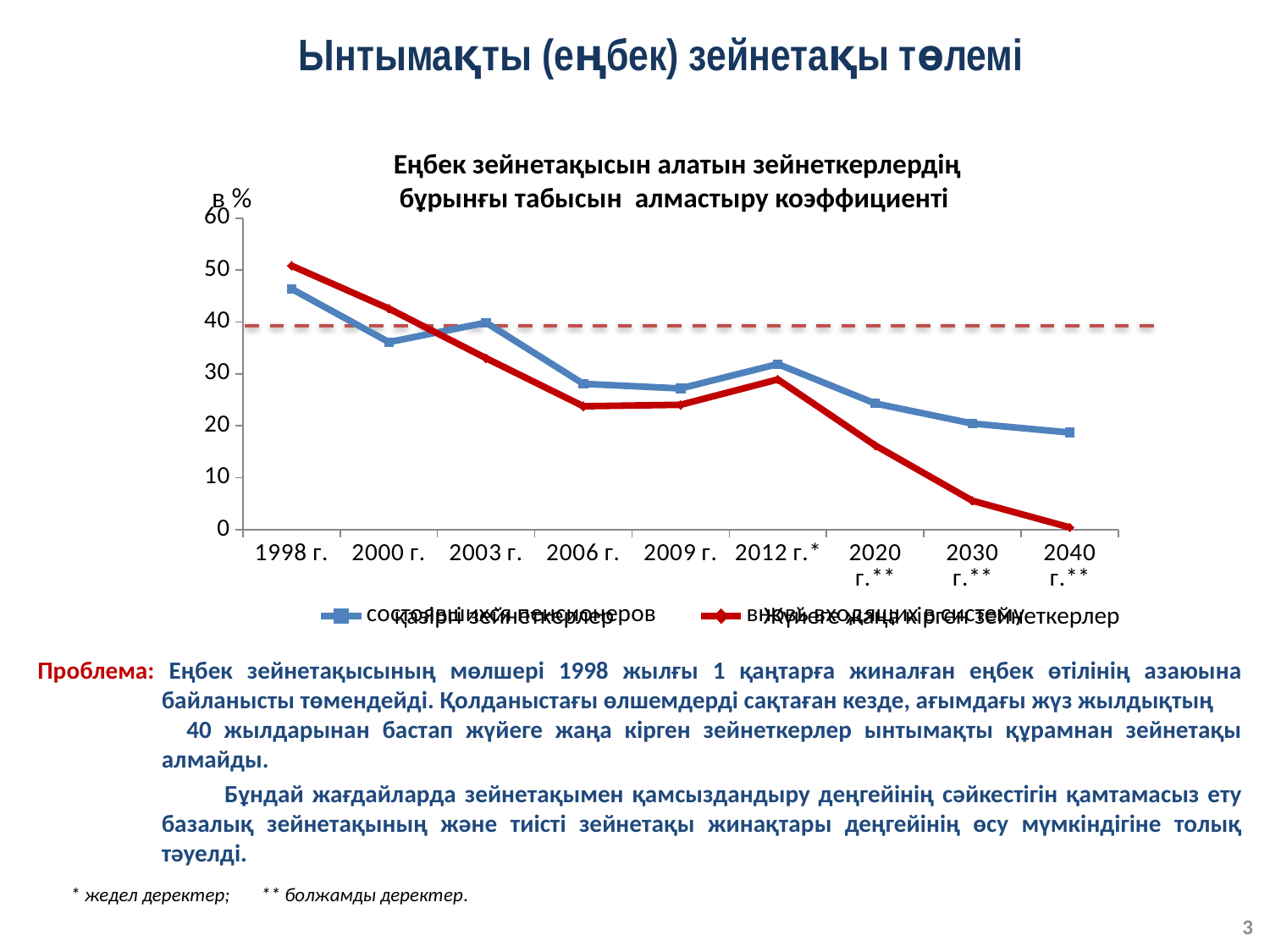
What kind of chart is shown on the slide? line chart What unit is indicated at the top of the vertical axis of the chart? в % Is the value of the blue series for 1998 г. greater or less than 40? greater In which year does the red series reach its highest value? 1998 г. How many series does the chart legend list? 2 At 2040 г.**, which series has the larger value, the blue one or the red one? the blue one In which year does the red series reach its lowest value? 2040 г.** Overall, do the values of the red series rise or fall from 1998 г. to 2040 г.**? fall In which year does the blue series reach its highest value? 1998 г. Is the value of the blue series for 2000 г. greater or less than 40? less How many year categories are shown along the x axis of the chart? 9 Is the value of the red series for 2030 г.** greater or less than 10? less